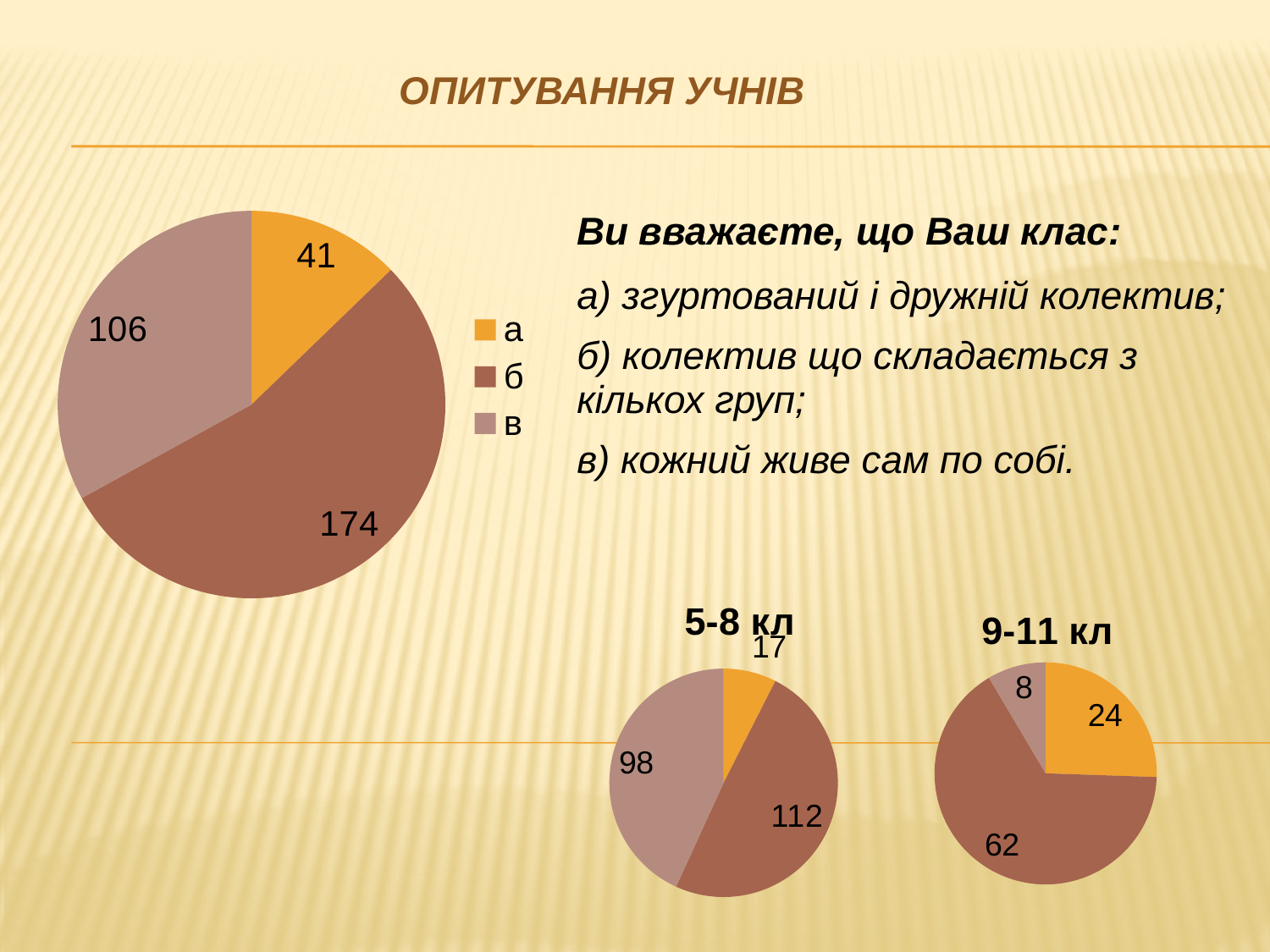
In the chart titled 9-11 кл, what is the value of the orange slice? 24 In the large pie chart on the left, which category has the smallest slice? а In the chart titled 9-11 кл, which is larger: the value 62 or the value 8? 62 In the large pie chart on the left, what is the value for category а? 41 What type of chart is the chart titled 5-8 кл? pie chart In the chart titled 5-8 кл, what is the value of the smallest slice? 17 How many slices does the chart titled 9-11 кл have? 3 How many entries does the legend of the large pie chart on the left list? 3 In the large pie chart on the left, what is the difference between the values for б and в? 68 In the chart titled 5-8 кл, what is the value of the largest slice? 112 In the large pie chart on the left, what is the value for category б? 174 In the large pie chart on the left, which category has the largest slice? б